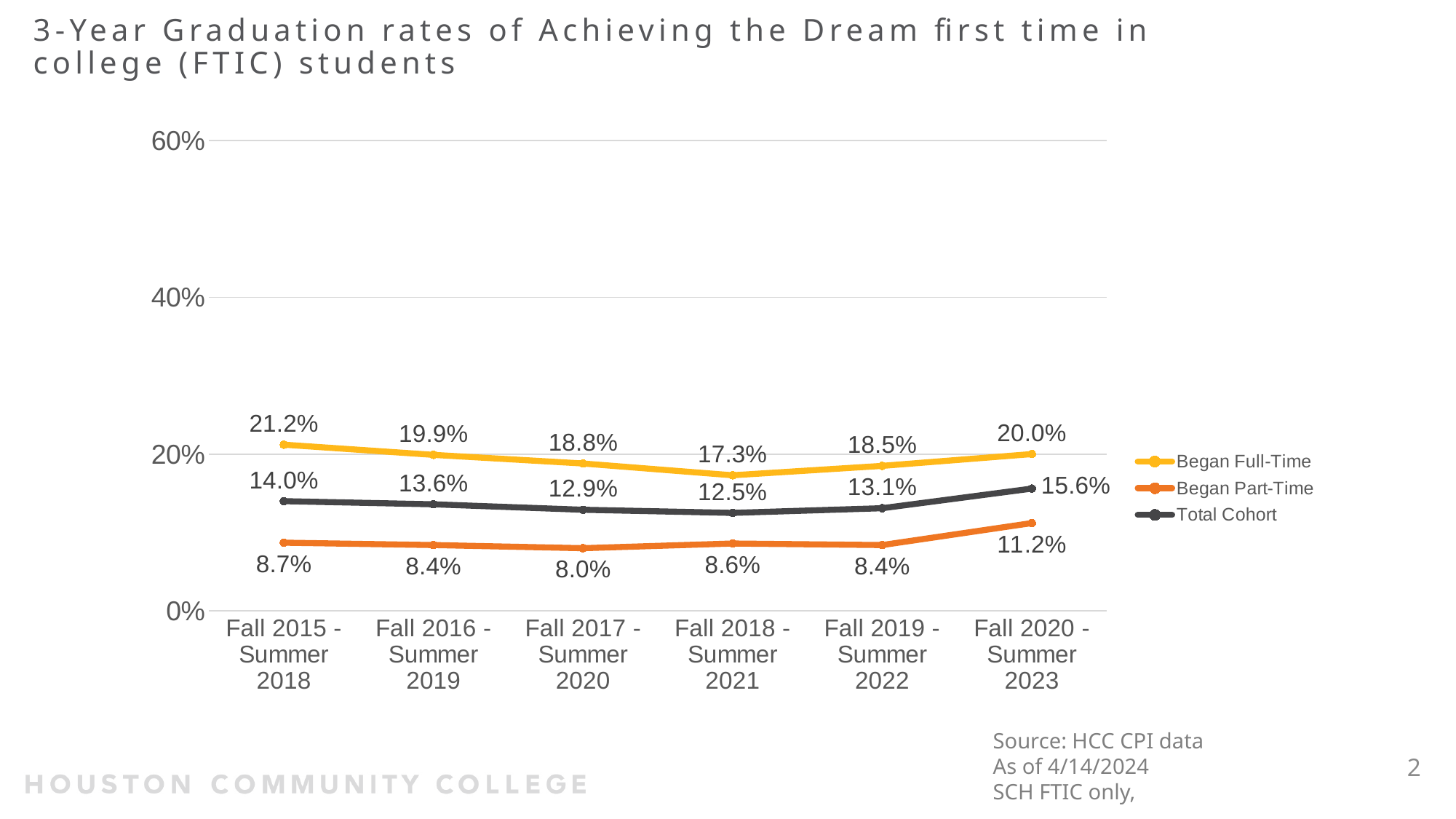
What is the difference between the Began Full-Time and Began Part-Time rates for Fall 2019 - Summer 2022? 10.1% Which cohort has the lowest Began Full-Time graduation rate? Fall 2018 - Summer 2021 What is the Total Cohort graduation rate for Fall 2020 - Summer 2023? 15.6% How many series does the legend list? 3 Is the Began Full-Time rate for Fall 2018 - Summer 2021 greater or less than 20%? less How many cohorts are shown on the x axis? 6 Which is larger for Fall 2016 - Summer 2019: the Total Cohort rate or the Began Part-Time rate? Total Cohort What is the Began Part-Time graduation rate for Fall 2017 - Summer 2020? 8.0% Which cohort has the highest Began Part-Time graduation rate? Fall 2020 - Summer 2023 Does the Total Cohort rate rise or fall from Fall 2019 - Summer 2022 to Fall 2020 - Summer 2023? rise What is the 3-year graduation rate for Began Full-Time students in the Fall 2015 - Summer 2018 cohort? 21.2% What kind of chart is shown on the slide? line chart